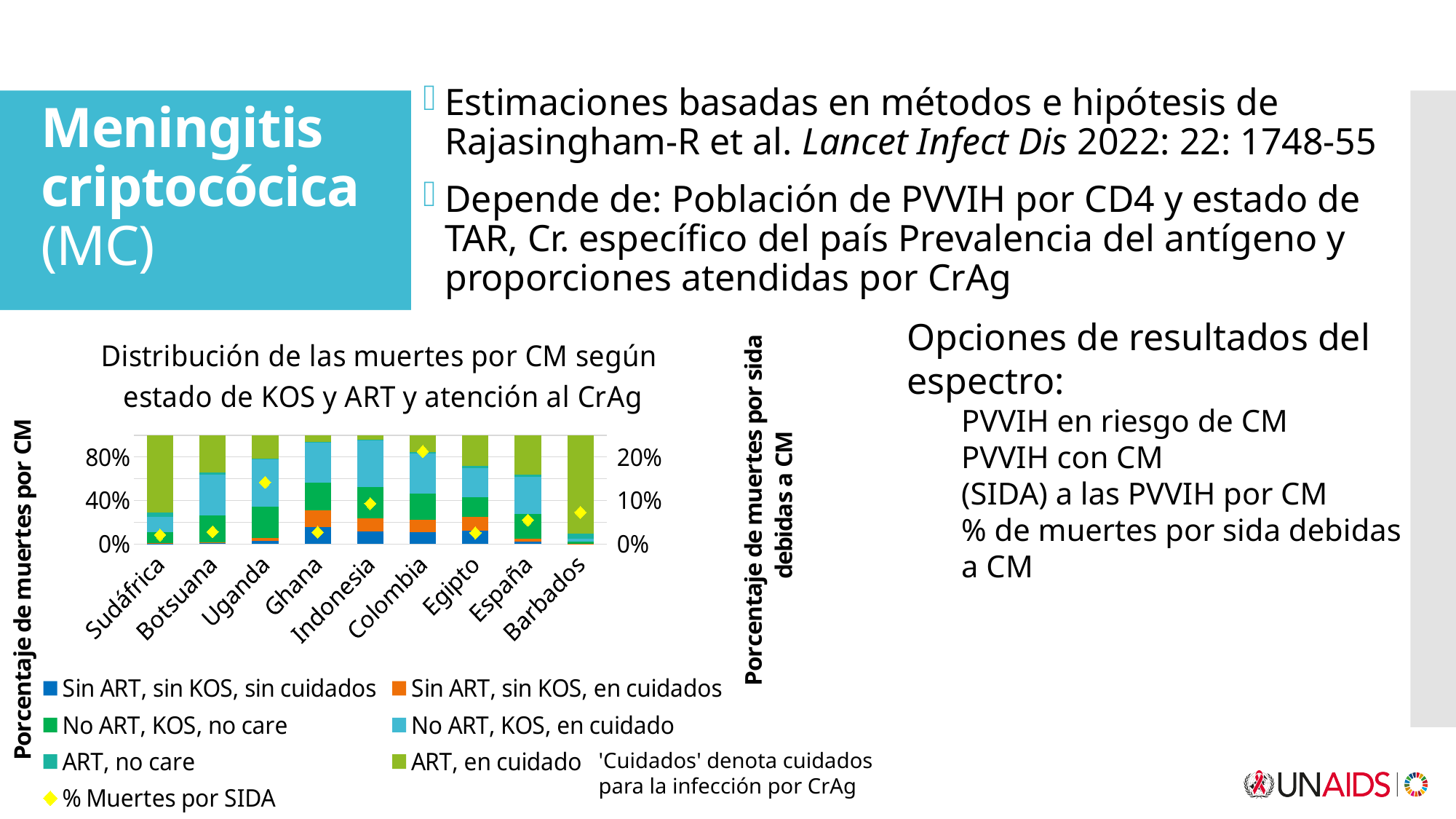
How many series does the chart legend list? 7 Which country has the highest value for '% Muertes por SIDA' (yellow diamond)? Colombia Which country has the largest 'ART, en cuidado' segment in its bar? Barbados What kind of chart is shown on the slide? combination chart: 100% stacked bars with a marker (line) series for '% Muertes por SIDA' Is the '% Muertes por SIDA' value for Barbados greater or less than 10%? less Is the '% Muertes por SIDA' value for Sudáfrica greater or less than 10%? less Is the '% Muertes por SIDA' value for Colombia greater or less than 10%? greater Which has a larger '% Muertes por SIDA' value, Uganda or Barbados? Uganda How many countries are shown on the x axis of the chart? 9 What is the label of the right-hand vertical axis of the chart? Porcentaje de muertes por sida debidas a CM What is the title of the chart? Distribución de las muertes por CM según estado de KOS y ART y atención al CrAg